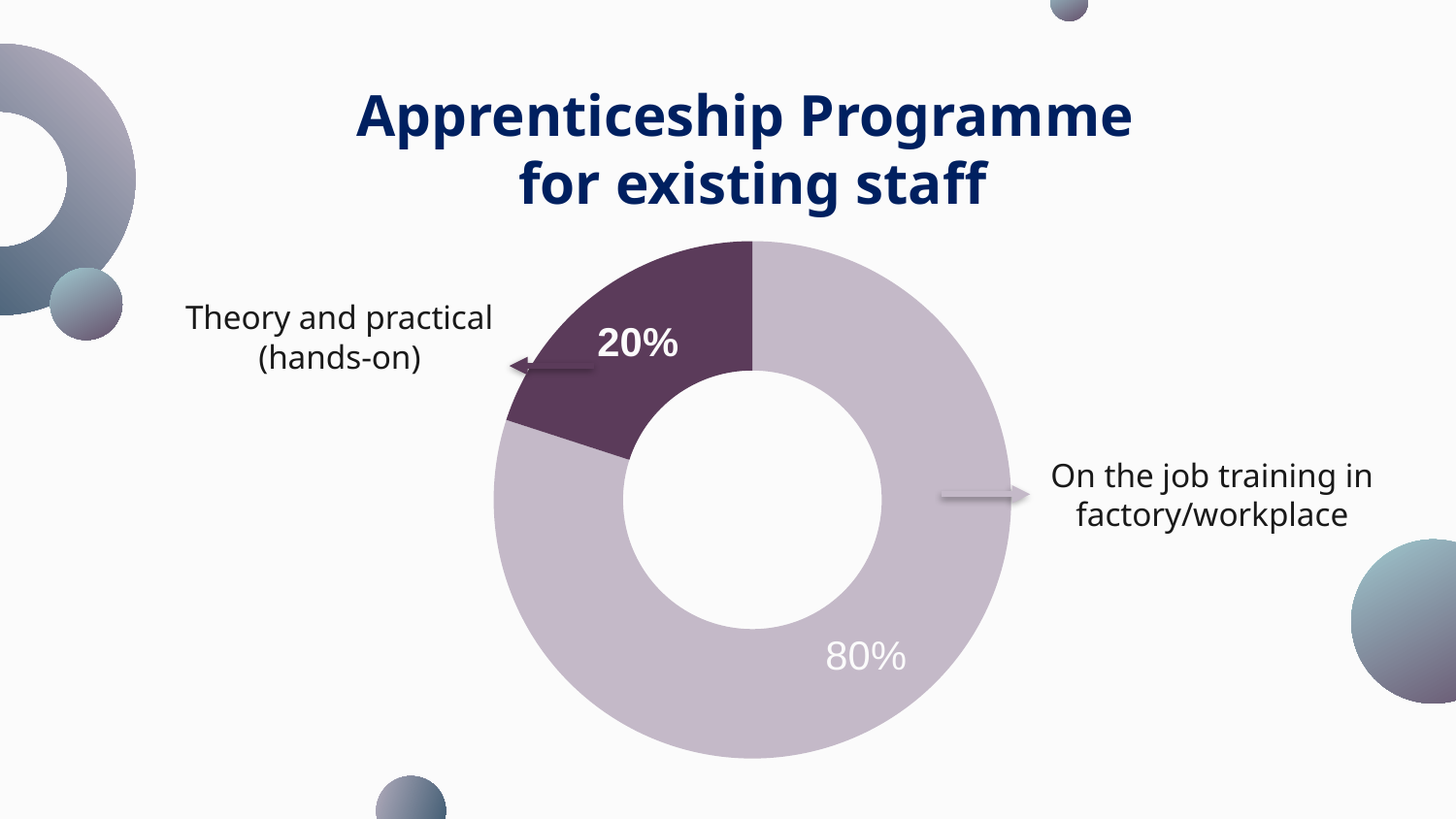
Which segment is the largest? On the job training in factory/workplace What kind of chart is shown on the slide? Pie chart (doughnut) What share of the chart does the 'Theory and practical (hands-on)' segment represent? 20% What is the title of the slide containing the chart? Apprenticeship Programme for existing staff Which segment is the smallest? Theory and practical (hands-on) What percentage is shown for 'Theory and practical (hands-on)'? 20% What is the difference in percentage points between the 'On the job training' segment and the 'Theory and practical' segment? 60 What percentage is shown for 'On the job training in factory/workplace'? 80% Which segment is shown in the darker purple colour? Theory and practical (hands-on) Which is larger: the share for 'Theory and practical (hands-on)' or the share for 'On the job training in factory/workplace'? On the job training in factory/workplace How many segments does the chart have? 2